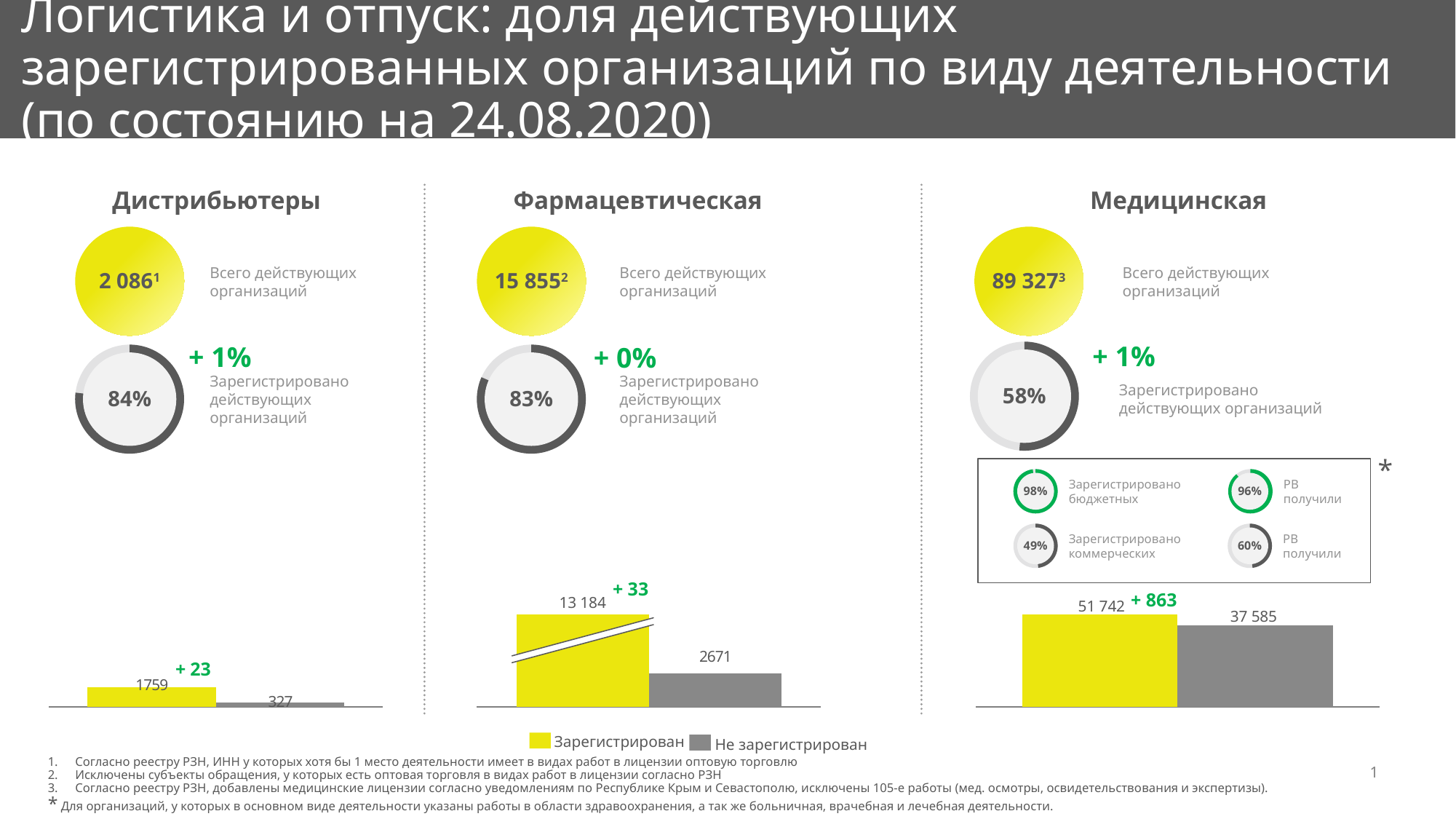
What percentage is shown in the Фармацевтическая donut chart for Зарегистрировано действующих организаций? 83% In the Дистрибьюторы bar chart, what is the value for Не зарегистрирован? 327 In the Медицинская bar chart, what is the difference between Зарегистрирован and Не зарегистрирован? 14 157 In the Медицинская section, what percentage is shown in the small donut for Зарегистрировано коммерческих? 49% In the Медицинская bar chart, what is the value for Не зарегистрирован? 37 585 How many series does the shared legend below the bar charts list? 2 In the Фармацевтическая bar chart, what is the value for Не зарегистрирован? 2671 What kind of chart is shown at the bottom of the Медицинская section? bar chart In the Фармацевтическая bar chart, which bar is larger, Зарегистрирован or Не зарегистрирован? Зарегистрирован In the Фармацевтическая bar chart, what is the value for Зарегистрирован? 13 184 In the Дистрибьюторы bar chart, what is the difference between Зарегистрирован and Не зарегистрирован? 1432 In the Дистрибьюторы bar chart, what is the value for Зарегистрирован? 1759